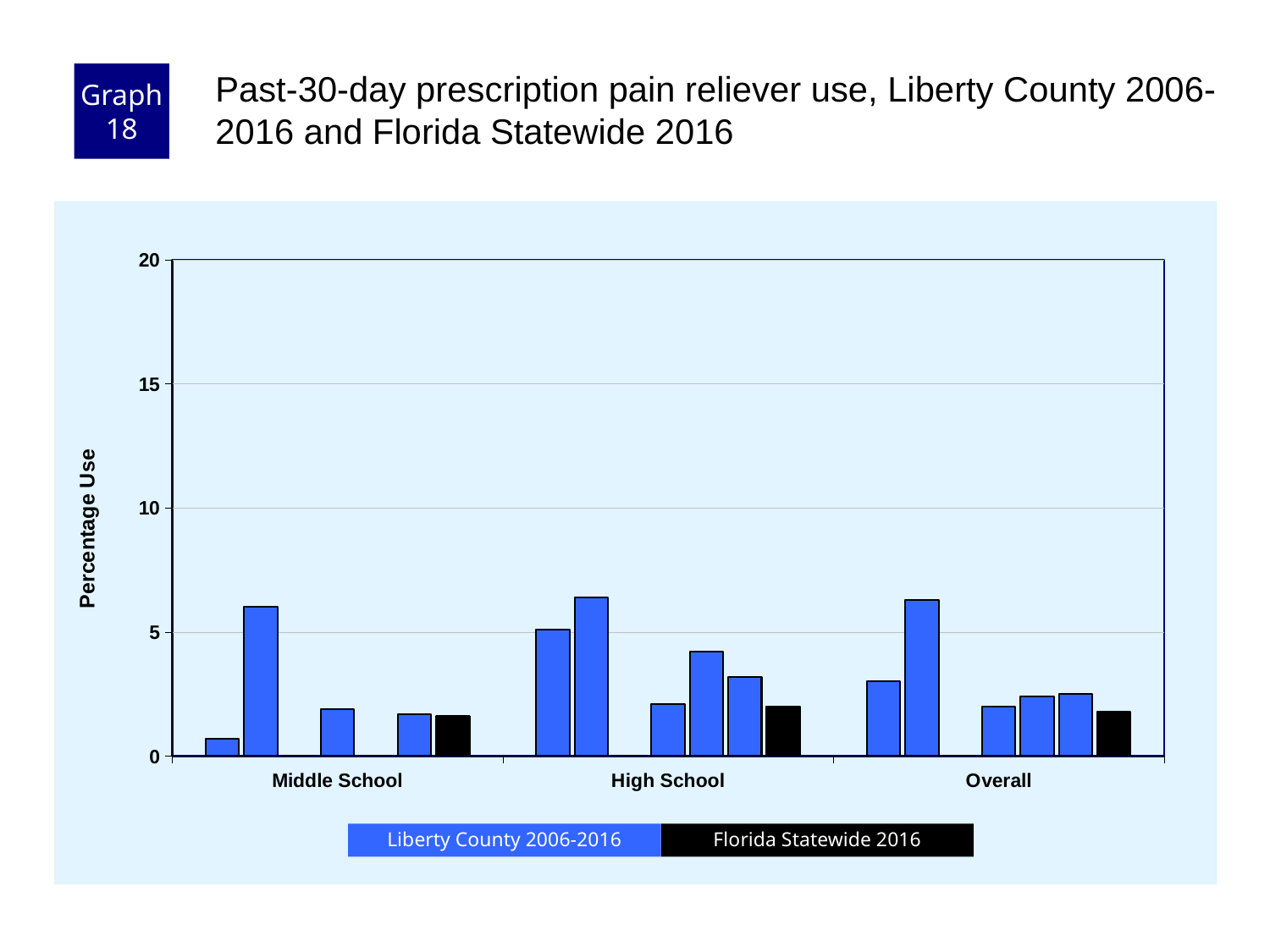
What kind of chart is shown on the slide? bar chart Is the tallest Liberty County 2006-2016 bar in the Middle School group greater or less than 5? greater Which colour represents Florida Statewide 2016 in the legend? black How many categories are shown on the x axis? 3 What is the label on the y axis? Percentage Use Is the value for Florida Statewide 2016 in the High School group greater or less than 5? less Is the value for Florida Statewide 2016 in the Overall group greater or less than 5? less How many series does the legend list? 2 In the Overall group, which is larger: the tallest Liberty County 2006-2016 bar or the Florida Statewide 2016 bar? Liberty County 2006-2016 In the High School group, which is larger: the tallest Liberty County 2006-2016 bar or the Florida Statewide 2016 bar? Liberty County 2006-2016